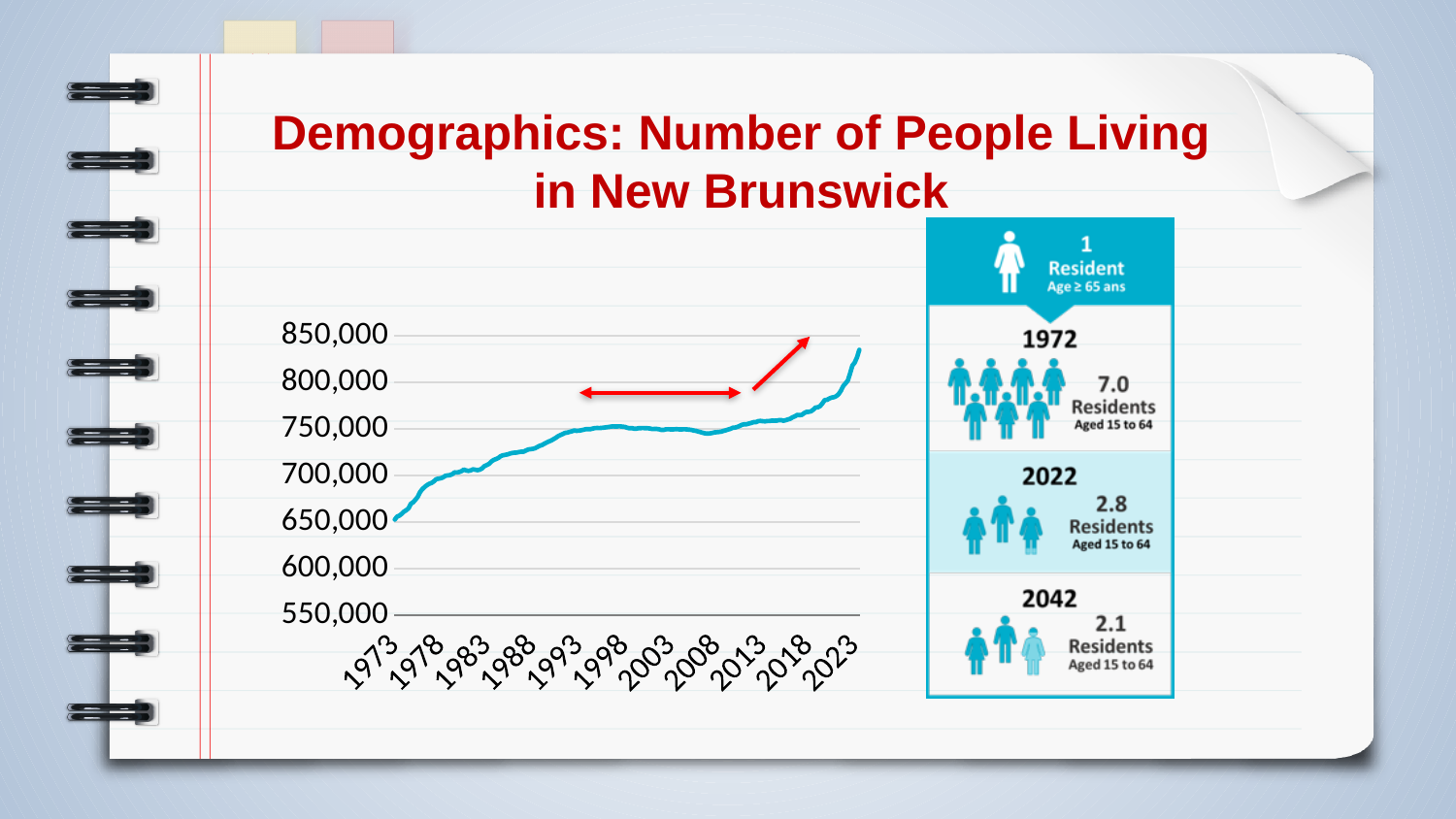
Does the number of people living in New Brunswick generally rise or fall from 1973 to 2023? Rise Which is larger, the value for 2023 or the value for 1993? 2023 How many year labels are shown on the x axis? 11 What kind of chart is shown on the slide? Line chart Is the value for 2023 greater or less than 800,000? greater Is the value for 2003 greater or less than 700,000? greater Is the value for 2013 greater or less than 800,000? less Which year labelled on the x axis has the highest population value? 2023 Which year labelled on the x axis has the lowest population value? 1973 What is the title of the slide containing the chart? Demographics: Number of People Living in New Brunswick